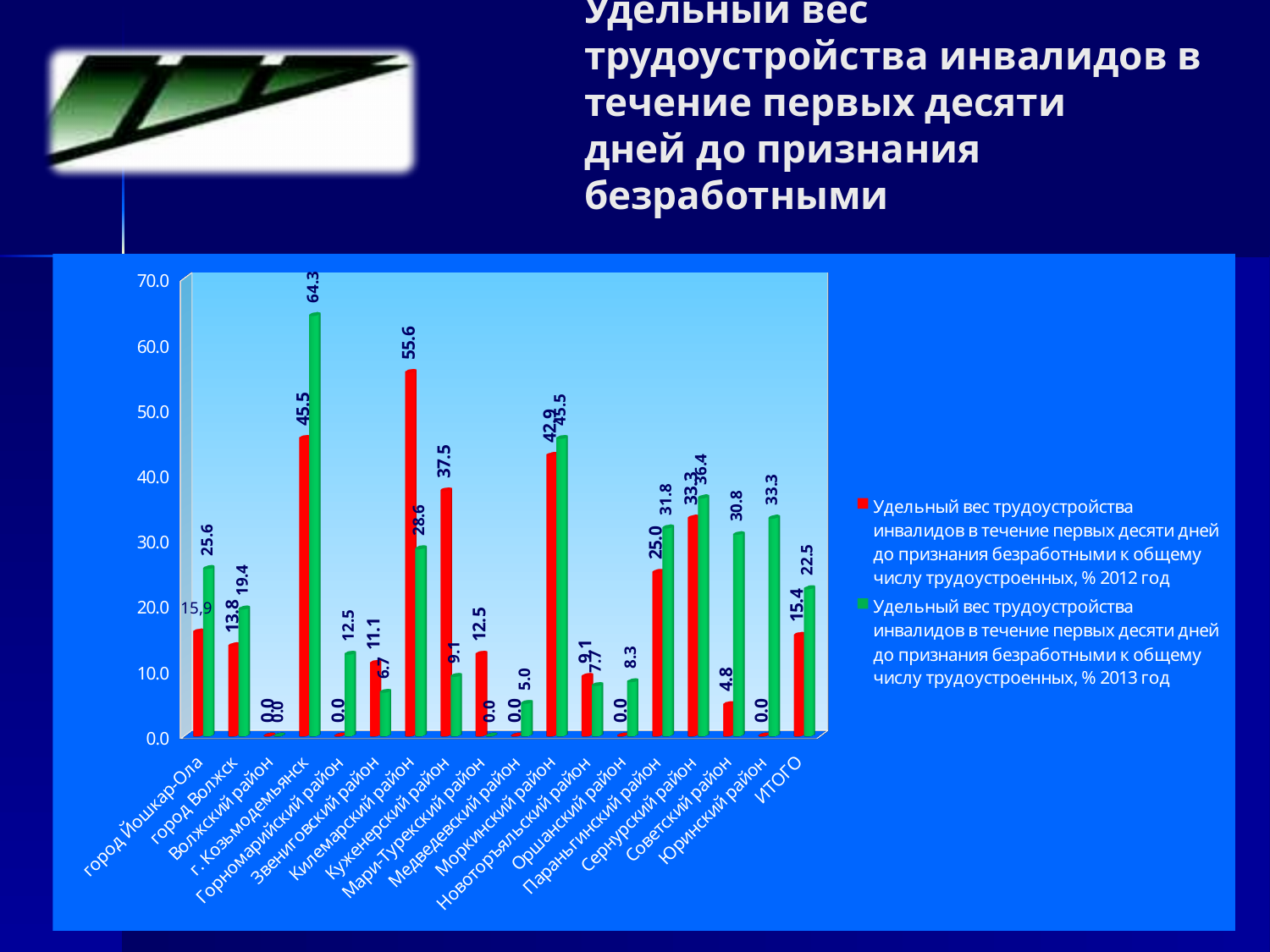
How many categories are shown on the x axis of the chart? 18 What is the 2013 value (green bar) for ИТОГО? 22.5 Which category has the highest 2013 value (green bar)? г. Козьмодемьянск What is the 2012 value (red bar) for Килемарский район? 55.6 What is the difference between the 2013 and 2012 values for Советский район? 26.0 What is the 2013 value (green bar) for г. Козьмодемьянск? 64.3 Which category has the highest 2012 value (red bar)? Килемарский район Which is larger for Куженерский район: the 2012 value or the 2013 value? 2012 value How many series does the legend list? 2 What type of chart is shown on the slide? bar chart Is the 2013 value (green bar) for Юринский район greater or less than 30.0? greater What colour are the bars for the 2013 series? green